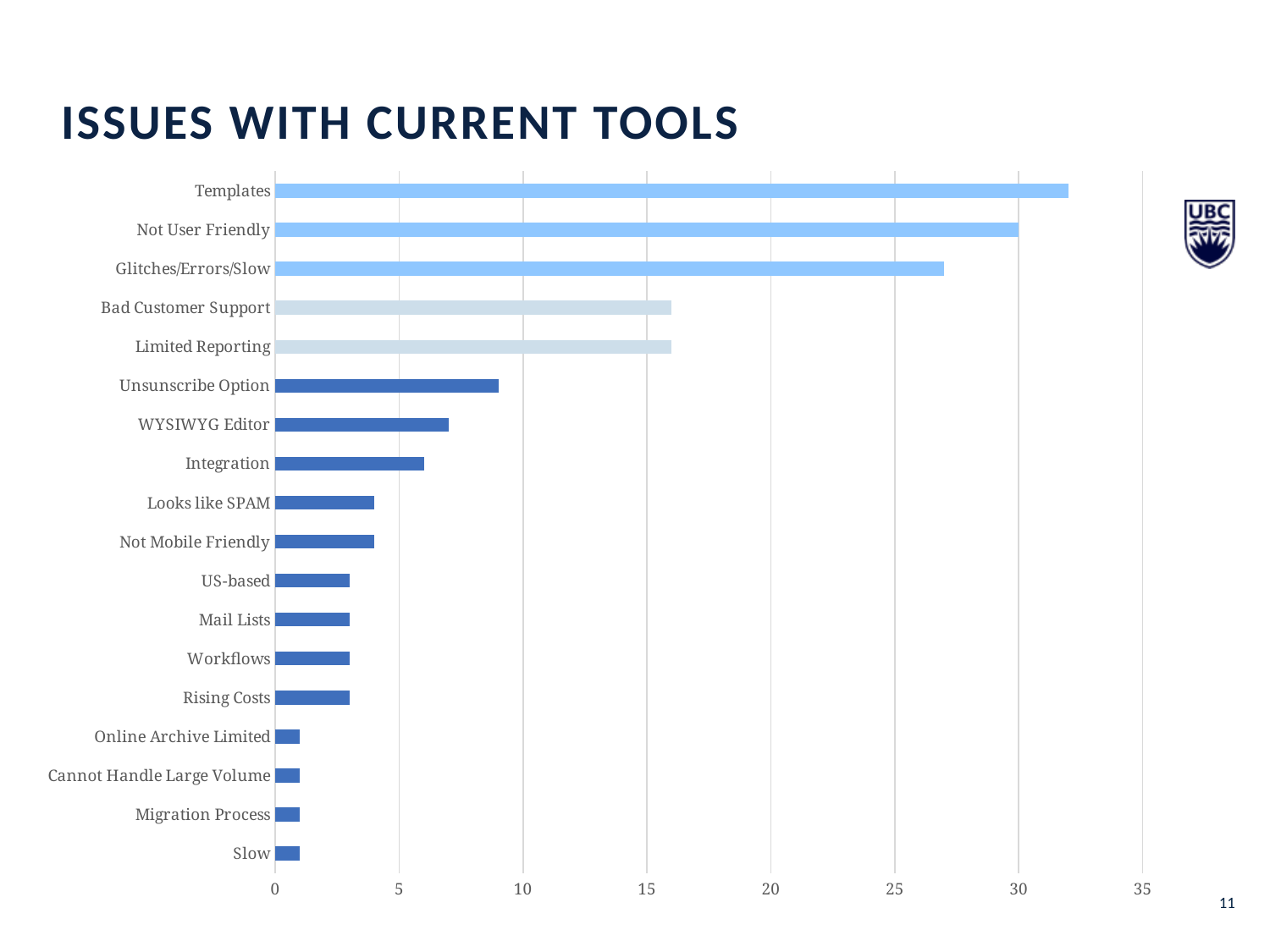
Is the value for Templates greater or less than 30? greater Which has a larger value, Limited Reporting or WYSIWYG Editor? Limited Reporting What kind of chart is shown on the slide? bar chart Is the value for Unsunscribe Option greater or less than 10? less Is the value for Glitches/Errors/Slow greater or less than 25? greater What is the title of the chart on the slide? ISSUES WITH CURRENT TOOLS Which issue has the highest value in the chart? Templates What is the value for Not User Friendly? 30 Which has a larger value, Templates or Glitches/Errors/Slow? Templates How many categories (issues) are plotted in the chart? 18